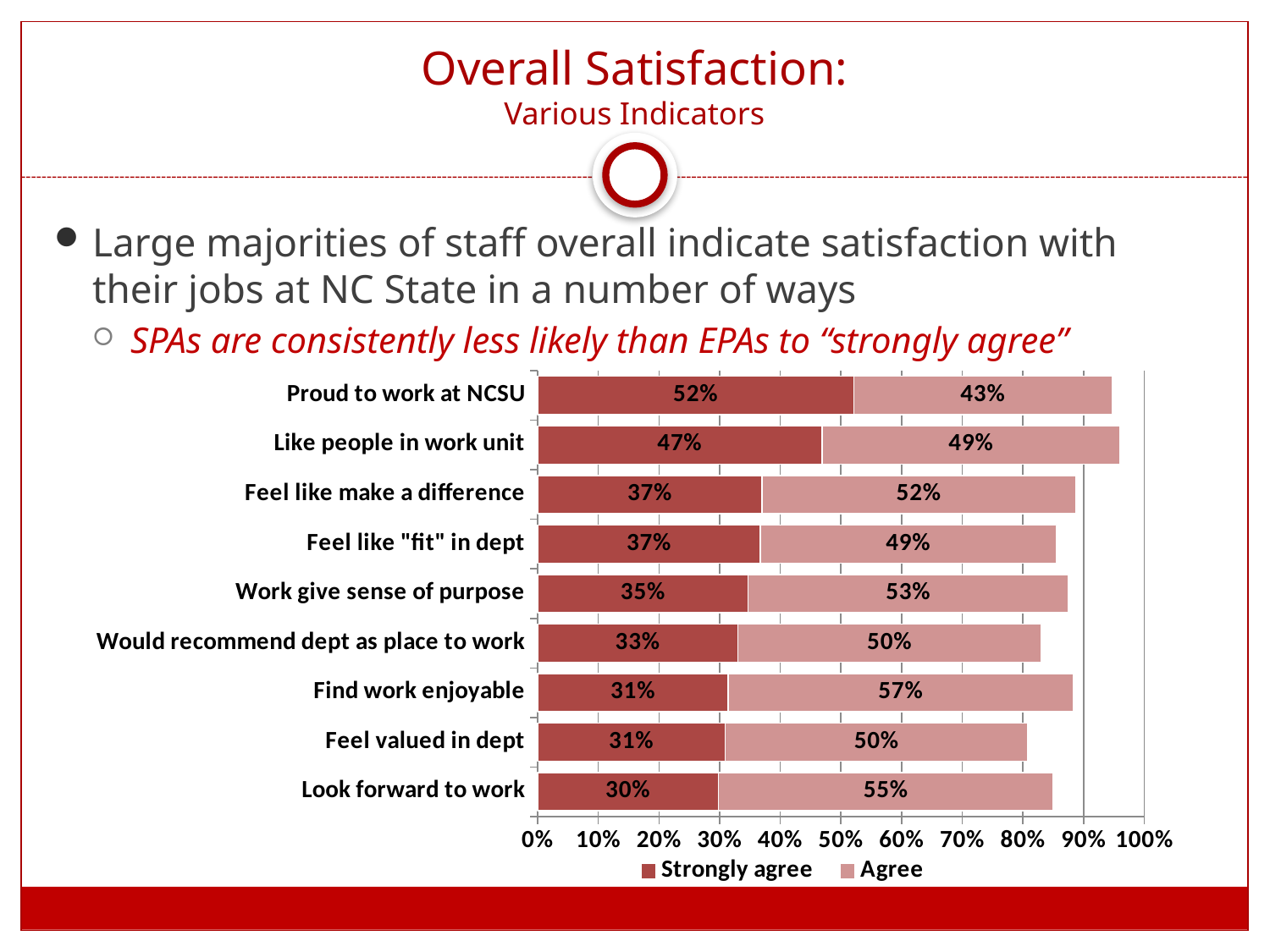
Which indicator has the highest 'Agree' percentage? Find work enjoyable How many series does the legend list? 2 What percentage of staff strongly agree that they are proud to work at NCSU? 52% Which indicator has the highest 'Strongly agree' percentage? Proud to work at NCSU Which indicator has the lowest 'Strongly agree' percentage? Look forward to work What is the combined total of 'Strongly agree' and 'Agree' for 'Like people in work unit'? 96% What type of chart is shown on the slide? Stacked bar chart What is the difference between the 'Strongly agree' values for 'Proud to work at NCSU' and 'Like people in work unit'? 5% What is the 'Strongly agree' value for 'Look forward to work'? 30% How many indicators (categories) are shown in the chart? 9 Which is larger: the 'Agree' value for 'Work give sense of purpose' or the 'Agree' value for 'Feel valued in dept'? Work give sense of purpose What percentage of staff agree (not strongly) that they find work enjoyable? 57%